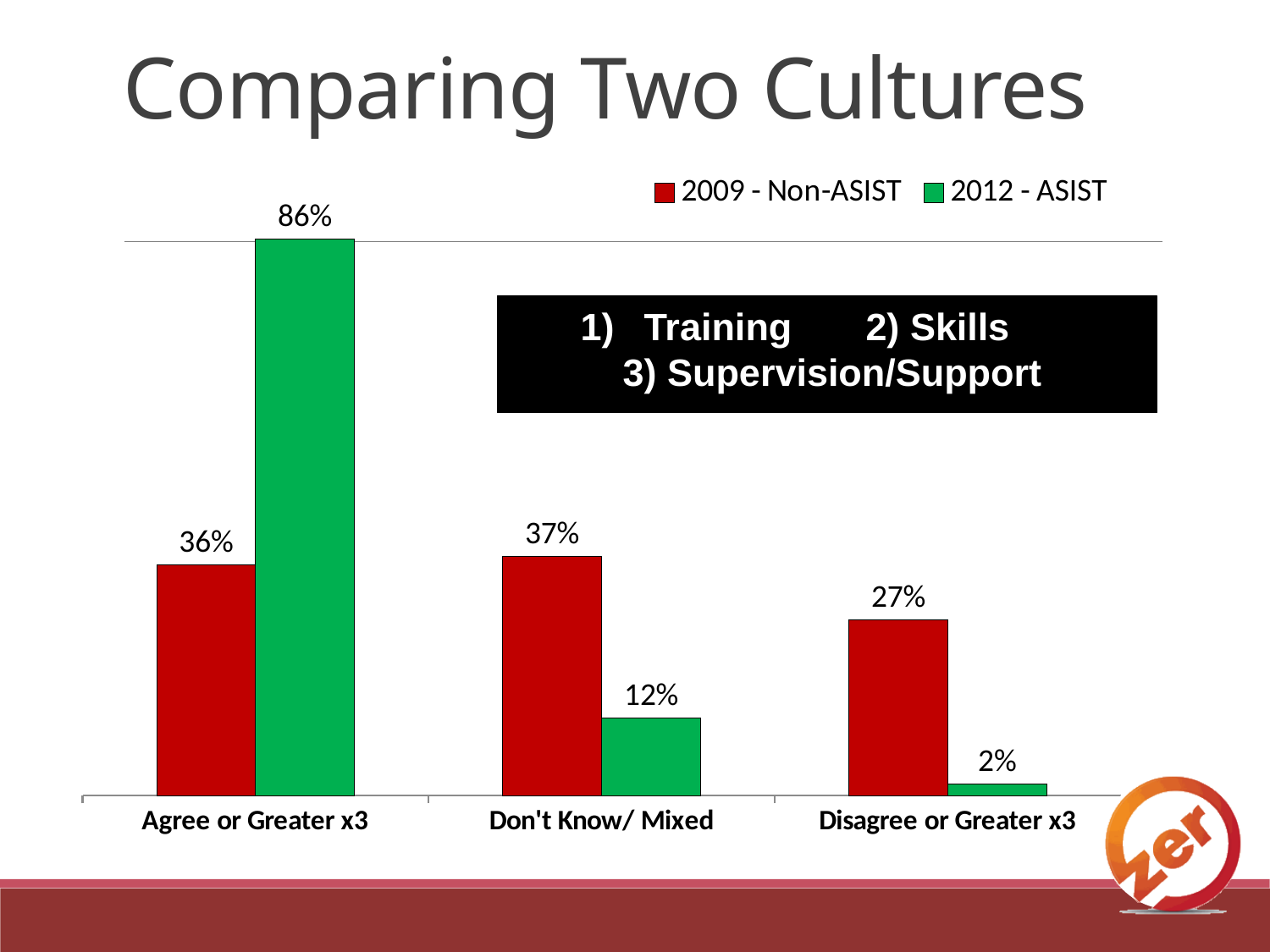
How many categories are shown on the x axis of the chart? 3 What is the difference between the 2009 - Non-ASIST and 2012 - ASIST values in the Don't Know/ Mixed category? 25% Which category has the highest value for the 2012 - ASIST series? Agree or Greater x3 How many series does the chart legend list? 2 What is the value for 2012 - ASIST in the Disagree or Greater x3 category? 2% What is the difference between the 2012 - ASIST and 2009 - Non-ASIST values in the Agree or Greater x3 category? 50% In the Disagree or Greater x3 category, which series has the larger value, 2009 - Non-ASIST or 2012 - ASIST? 2009 - Non-ASIST What is the value for 2009 - Non-ASIST in the Don't Know/ Mixed category? 37% What is the value for 2009 - Non-ASIST in the Disagree or Greater x3 category? 27% What kind of chart is shown on the slide? Bar chart What is the value for 2012 - ASIST in the Agree or Greater x3 category? 86% Which category has the lowest value for the 2012 - ASIST series? Disagree or Greater x3